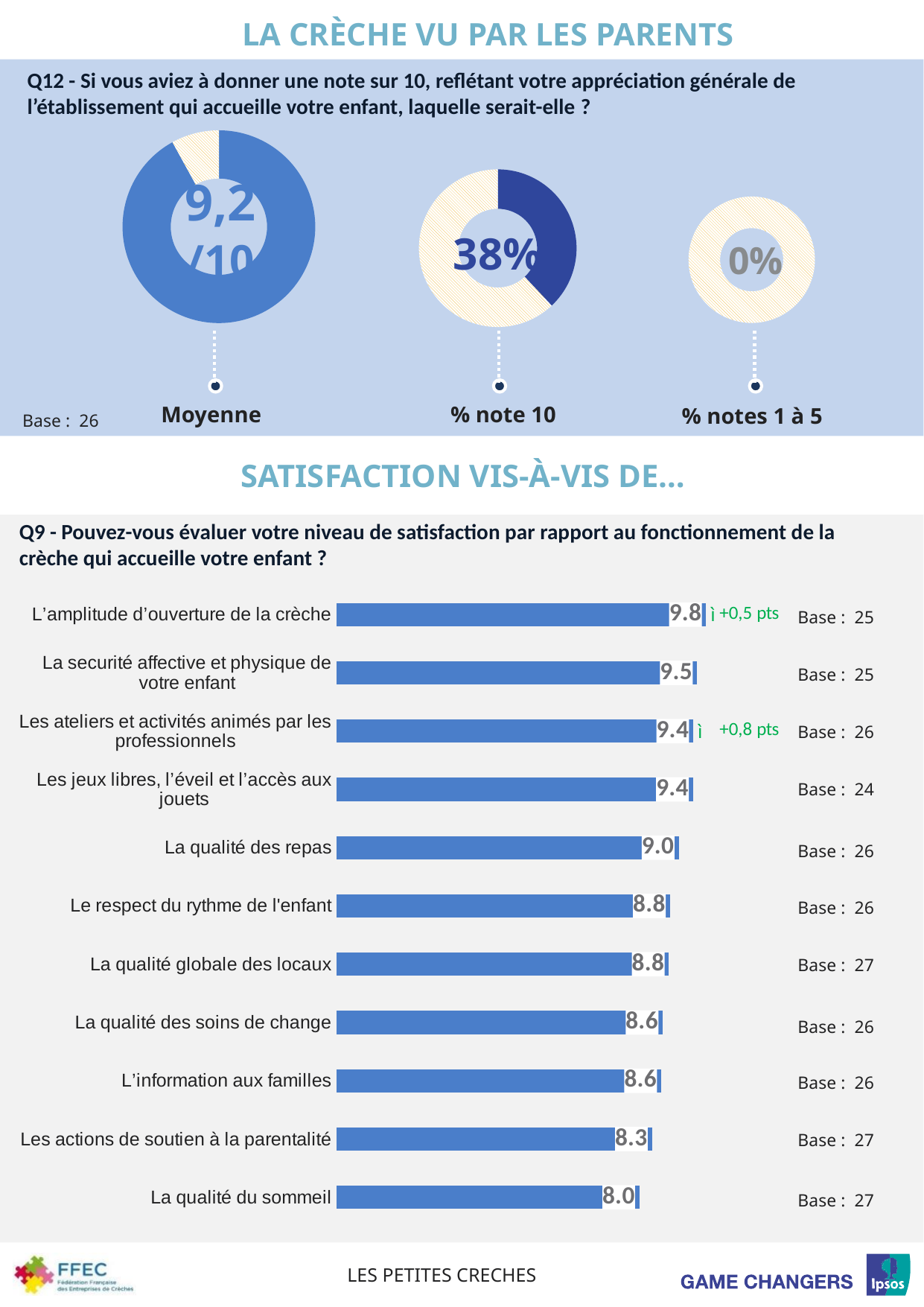
In the bar chart for Q9, which category has the lowest satisfaction score? La qualité du sommeil In the bar chart for Q9, what is the base (number of respondents) for 'La qualité globale des locaux'? 27 In the bar chart for Q9, what is the satisfaction score for 'La qualité du sommeil'? 8.0 In the donut chart labelled '% note 10', what percentage is shown? 38% In the bar chart for Q9, what is the satisfaction score for 'La qualité des repas'? 9.0 What type of chart is used for Q9 (satisfaction levels)? Bar chart How many categories are shown in the bar chart for Q9? 11 In the bar chart for Q9, what is the difference between the scores for 'L'amplitude d'ouverture de la crèche' and 'La qualité du sommeil'? 1.8 In the donut chart labelled '% notes 1 à 5', what percentage is shown? 0% In the bar chart for Q9, which has a higher score: 'La sécurité affective et physique de votre enfant' or 'Les actions de soutien à la parentalité'? La sécurité affective et physique de votre enfant In the donut chart labelled 'Moyenne', what average score is shown? 9,2/10 In the bar chart for Q9, which category has the highest satisfaction score? L'amplitude d'ouverture de la crèche